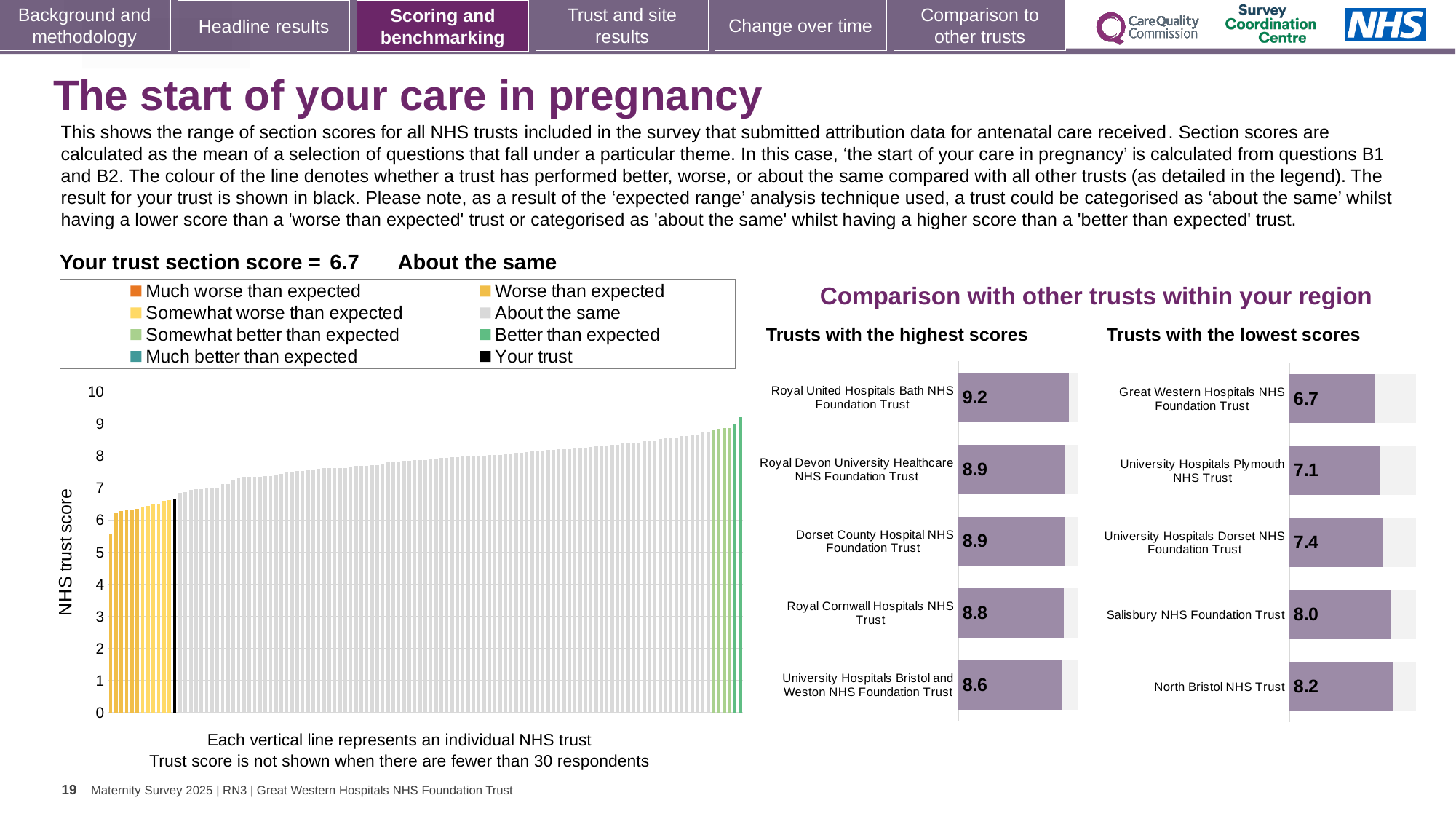
In the 'Trusts with the highest scores' chart, which trust has the lowest score shown? University Hospitals Bristol and Weston NHS Foundation Trust In the 'Trusts with the highest scores' chart, what is the difference between the scores of Royal United Hospitals Bath NHS Foundation Trust and Royal Cornwall Hospitals NHS Trust? 0.4 In the NHS trust score chart on the left, is the value for your trust (the black bar) greater or less than 7? less How many entries does the legend above the NHS trust score chart list? 8 In the NHS trust score chart on the left, do the bar values rise or fall from left to right? rise In the NHS trust score chart on the left, what is the section score for your trust (the black bar)? 6.7 How many trusts are listed in the 'Trusts with the highest scores' chart? 5 In the 'Trusts with the lowest scores' chart, which has the larger score: Salisbury NHS Foundation Trust or University Hospitals Dorset NHS Foundation Trust? Salisbury NHS Foundation Trust In the 'Trusts with the lowest scores' chart, which trust has the highest score shown? North Bristol NHS Trust In the 'Trusts with the highest scores' chart, what is the score for Royal United Hospitals Bath NHS Foundation Trust? 9.2 In the 'Trusts with the lowest scores' chart, what is the score for University Hospitals Plymouth NHS Trust? 7.1 In the 'Trusts with the lowest scores' chart, what is the difference between the scores of North Bristol NHS Trust and Great Western Hospitals NHS Foundation Trust? 1.5